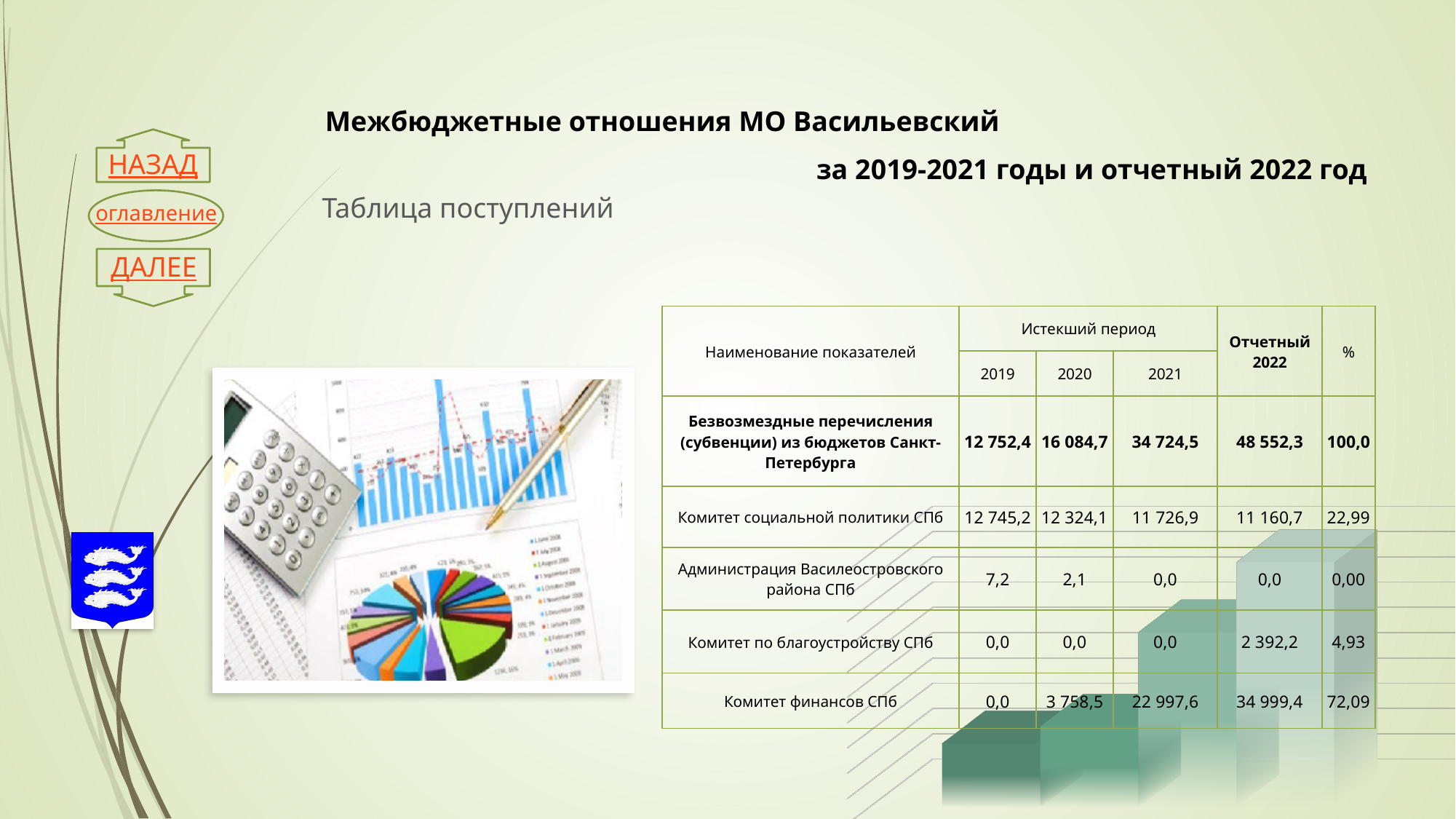
What kind of chart is shown in the lower right of the slide, behind the table? bar chart How many bars does the bar chart behind the table have? 4 Do the bars in the bar chart behind the table get taller or shorter from left to right? taller